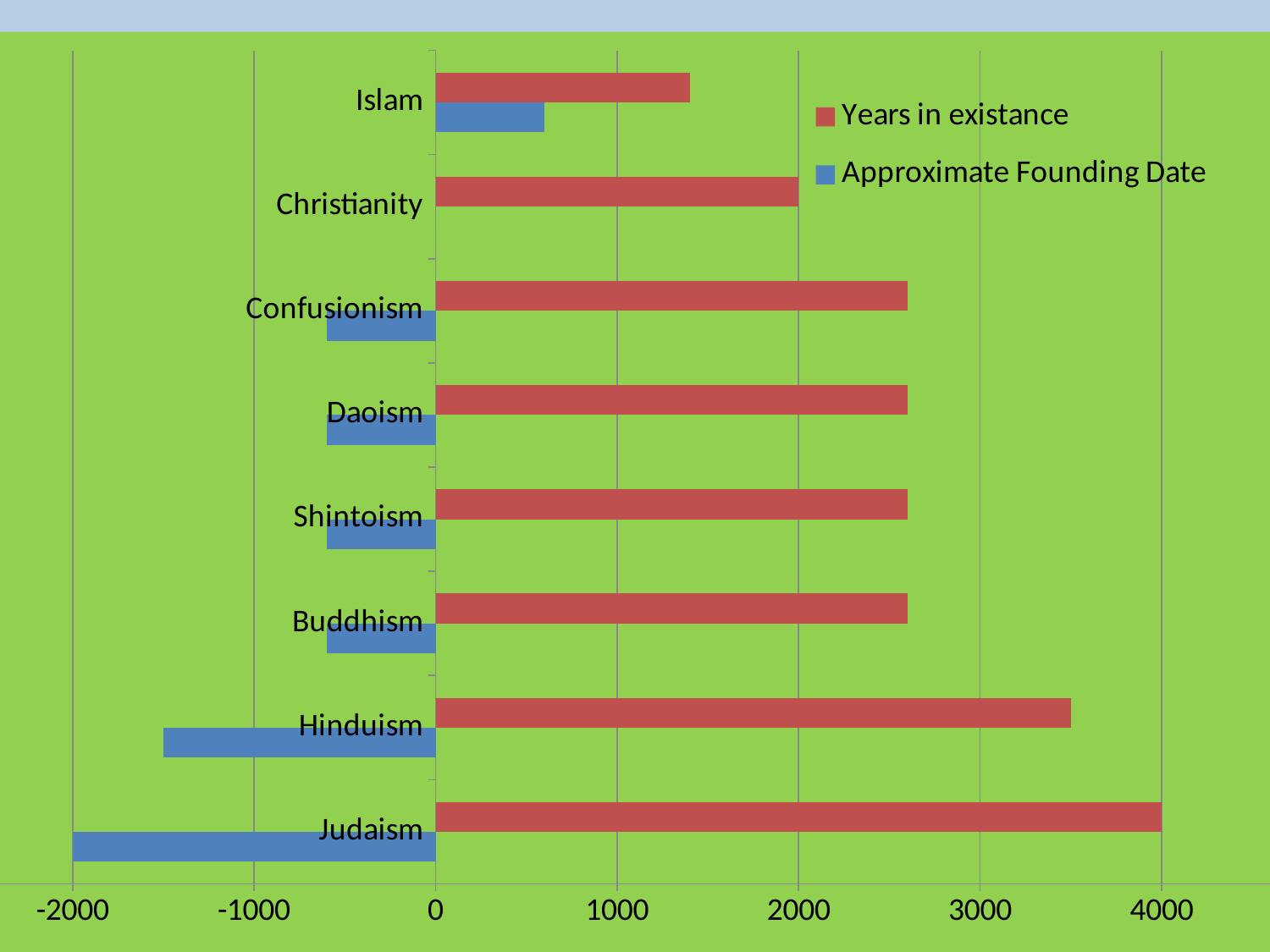
What is the value of Years in existance for Christianity? 2000 Which religion has the highest Years in existance value? Judaism Is the Years in existance value for Hinduism greater or less than 3000? greater Is the Approximate Founding Date value for Confusionism greater or less than 0? less How many religions (categories) are shown on the chart? 8 Which has a larger Years in existance value, Hinduism or Buddhism? Hinduism What is the value of Years in existance for Judaism? 4000 Which colour represents the Approximate Founding Date series? blue What is the Approximate Founding Date value for Judaism? -2000 Which religion has the lowest Years in existance value? Islam What kind of chart is shown on the slide? bar chart How many series does the legend list? 2